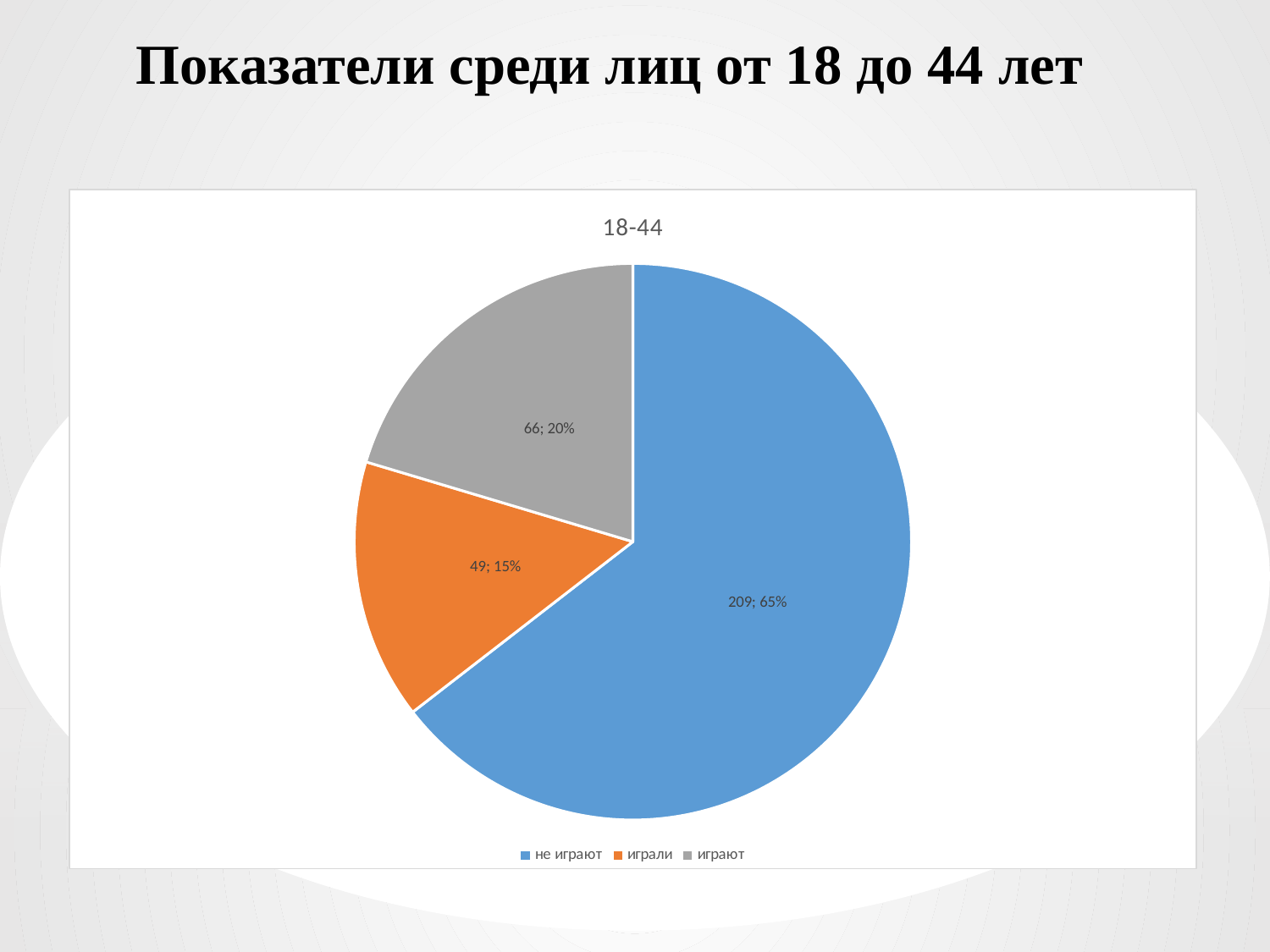
What type of chart is shown on the slide? pie chart How many slices does the pie chart have? 3 What is the value for 'не играют'? 209 What is the value for 'играли'? 49 What share of the pie does 'играют' represent? 20% What is the difference between the values for 'играют' and 'играли'? 17 What share of the pie does 'не играют' represent? 65% How many entries does the legend list? 3 Which category has the smallest slice? играли Which category has the largest slice? не играют What is the value for 'играют'? 66 What is the chart's title? 18-44